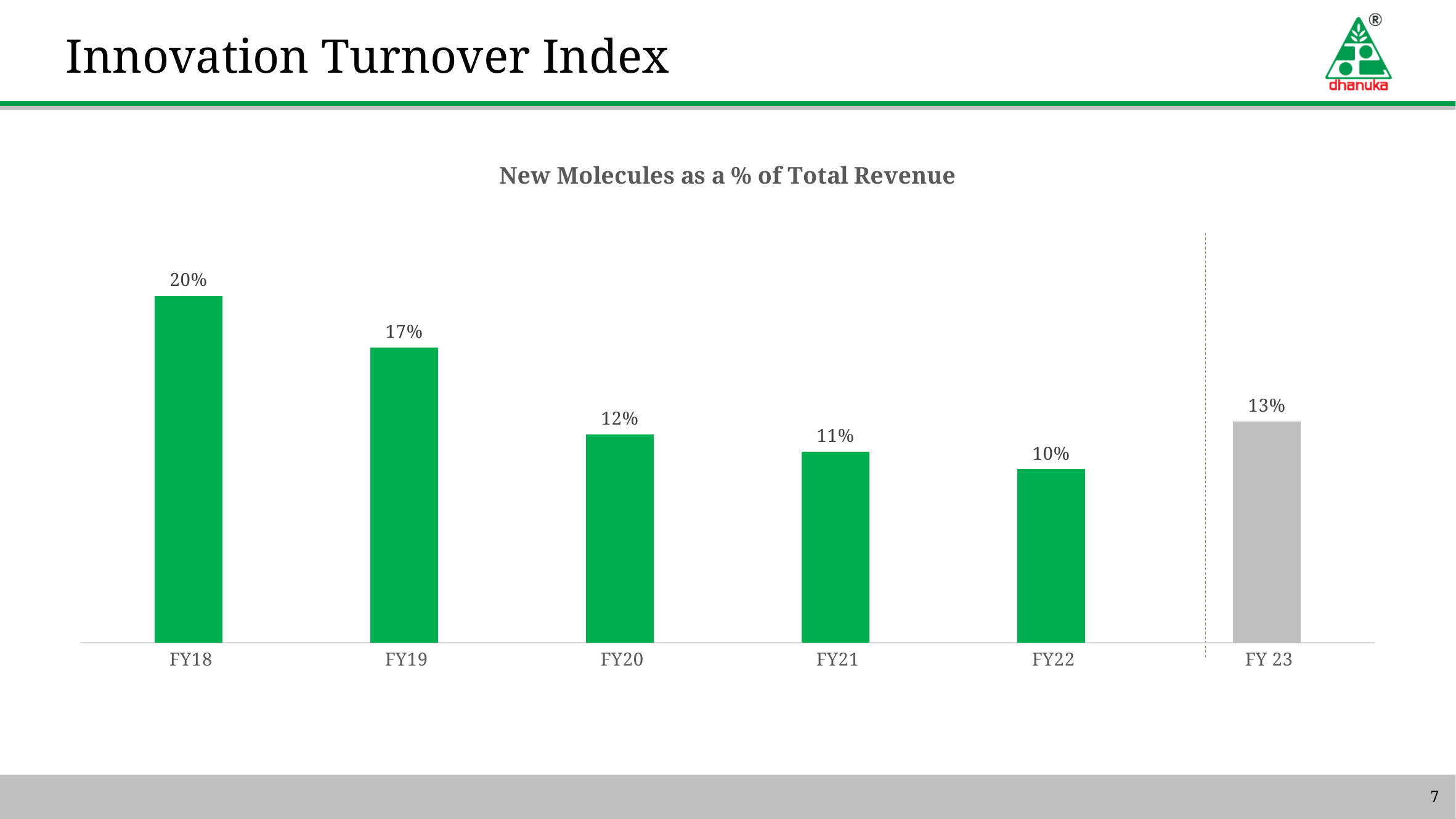
What kind of chart is shown? bar chart What is the difference between the FY18 and FY19 values? 3% What is the value for FY18? 20% Which year has the lowest value? FY22 Which is larger, the value for FY21 or the value for FY 23? FY 23 Which year has the highest value? FY18 What is the value for FY 23? 13% Do the values rise or fall from FY18 to FY22? fall How many years are shown on the chart? 6 What is the value for FY20? 12% What is the difference between the FY 23 and FY22 values? 3% What is the title of the chart? New Molecules as a % of Total Revenue